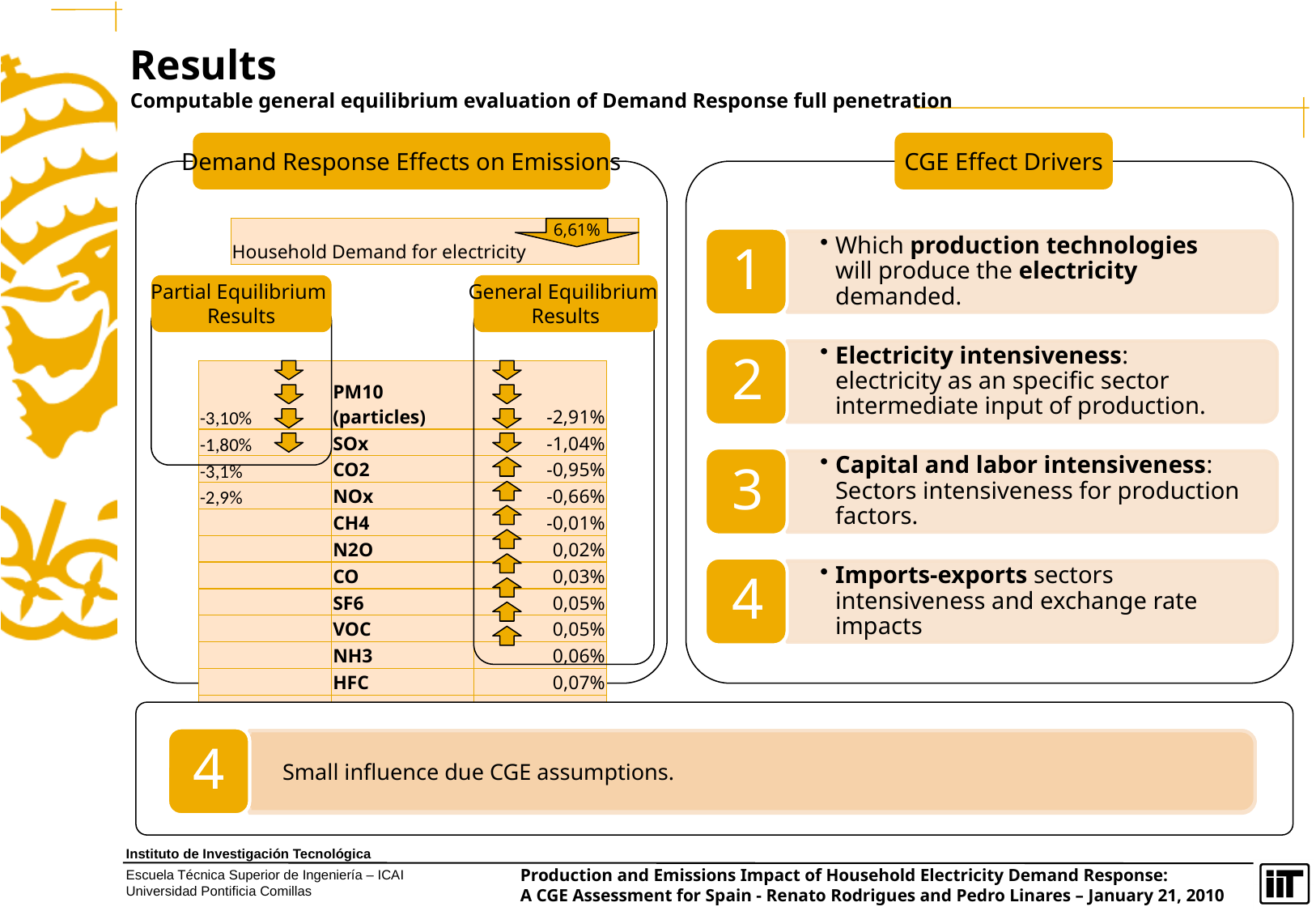
In the Demand Response Effects on Emissions table, what is the General Equilibrium result for HFC? 0,07% In the Demand Response Effects on Emissions table, which pollutant has the largest reduction in the General Equilibrium results? PM10 (particles) What percentage change is shown for Household Demand for electricity? 6,61% In the Demand Response Effects on Emissions table, which pollutant has the highest General Equilibrium value? HFC How many result columns (equilibrium types) does the Demand Response Effects on Emissions table compare? 2 In the Demand Response Effects on Emissions table, what is the General Equilibrium result for PM10 (particles)? -2,91% In the Demand Response Effects on Emissions table, what is the difference between the Partial Equilibrium and General Equilibrium results for CO2? 2,15 percentage points In the Demand Response Effects on Emissions table, what is the Partial Equilibrium result for SOx? -1,80% How many pollutants are listed in the Demand Response Effects on Emissions table? 11 In the Demand Response Effects on Emissions table, what is the Partial Equilibrium result for NOx? -2,9% In the Demand Response Effects on Emissions table, what is the General Equilibrium result for CO2? -0,95% In the Demand Response Effects on Emissions table, is the General Equilibrium reduction for SOx larger or smaller than the Partial Equilibrium reduction for SOx? smaller